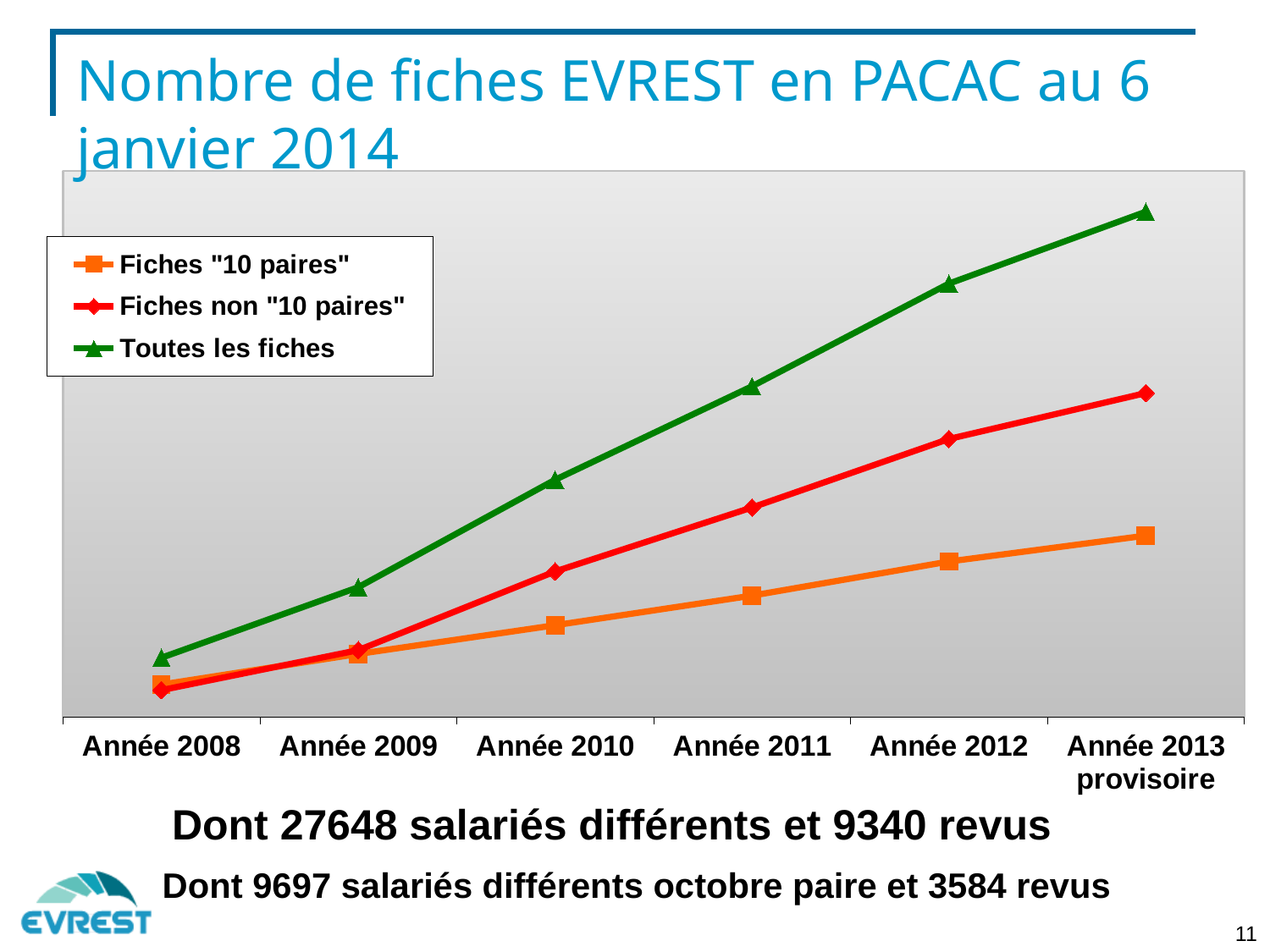
Which series has the lowest value in Année 2013 provisoire? Fiches "10 paires" How many years (categories) are shown on the x axis? 6 Do the values for "Toutes les fiches" rise or fall from Année 2008 to Année 2013 provisoire? rise Which series has the highest value in Année 2013 provisoire? Toutes les fiches In Année 2011, which is larger: Toutes les fiches or Fiches non "10 paires"? Toutes les fiches Do the values for Fiches "10 paires" rise or fall across the years shown? rise What kind of chart is shown on the slide? line chart What is the first year shown on the x axis? Année 2008 What is the title of the slide containing the chart? Nombre de fiches EVREST en PACAC au 6 janvier 2014 How many series does the legend list? 3 What colour is the line for "Toutes les fiches"? green In Année 2012, which is larger: Fiches non "10 paires" or Fiches "10 paires"? Fiches non "10 paires"